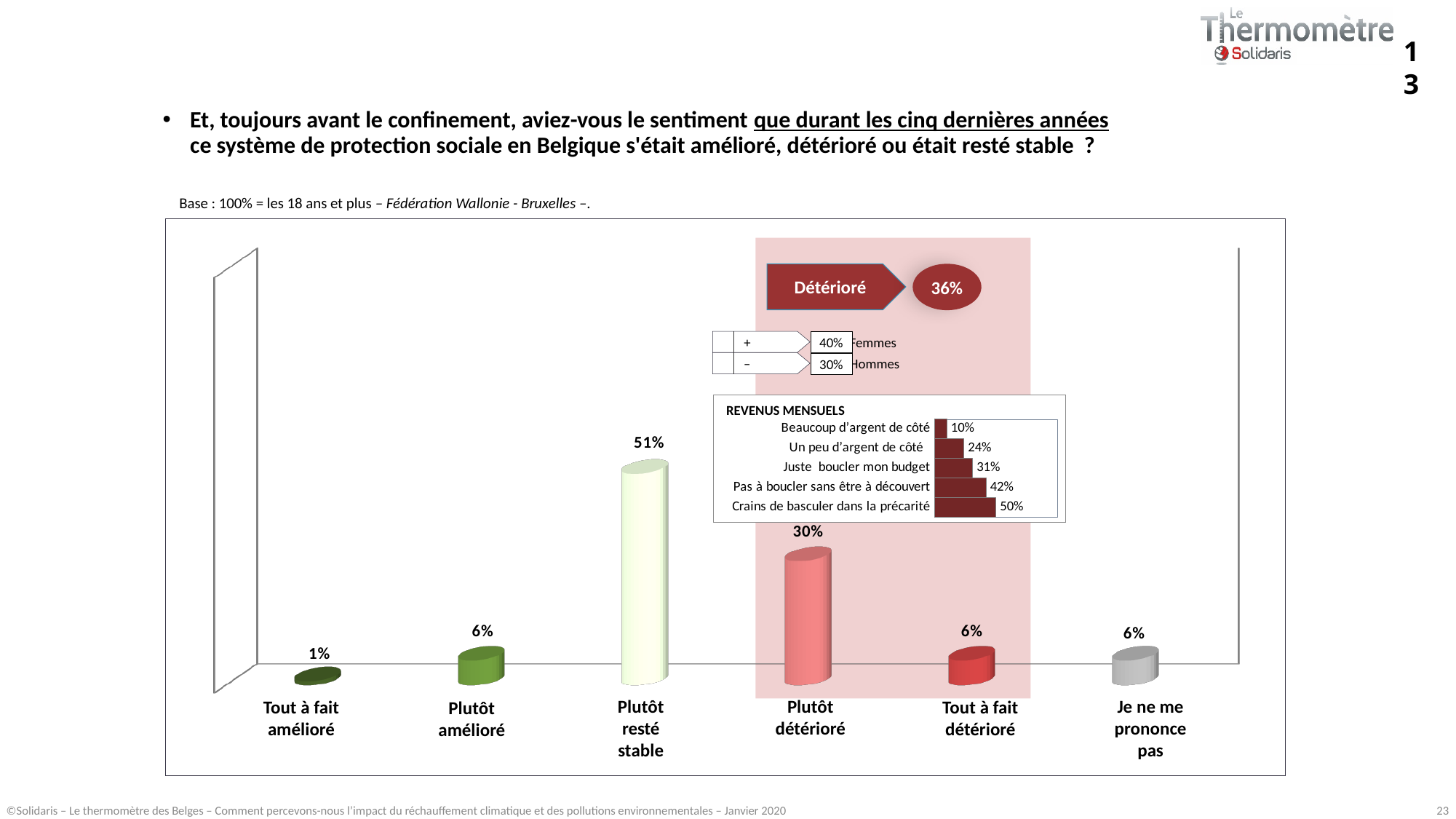
In the "REVENUS MENSUELS" inset chart, do the values rise or fall going down the list from "Beaucoup d'argent de côté" to "Crains de basculer dans la précarité"? Rise What kind of chart is the main chart? Bar chart In the main chart, which category has the lowest value? Tout à fait amélioré In the "REVENUS MENSUELS" inset chart, how many categories are shown? 5 In the "REVENUS MENSUELS" inset chart, which category has the lowest value? Beaucoup d'argent de côté In the main chart, what is the value for "Tout à fait amélioré"? 1% In the "REVENUS MENSUELS" inset chart, what is the value for "Crains de basculer dans la précarité"? 50% In the main chart, how many categories are shown? 6 In the main chart, what is the value for "Plutôt resté stable"? 51% In the main chart, what is the difference between "Plutôt resté stable" and "Plutôt détérioré"? 21 percentage points In the main chart, what is the value for "Plutôt détérioré"? 30% In the main chart, which category has the highest value? Plutôt resté stable